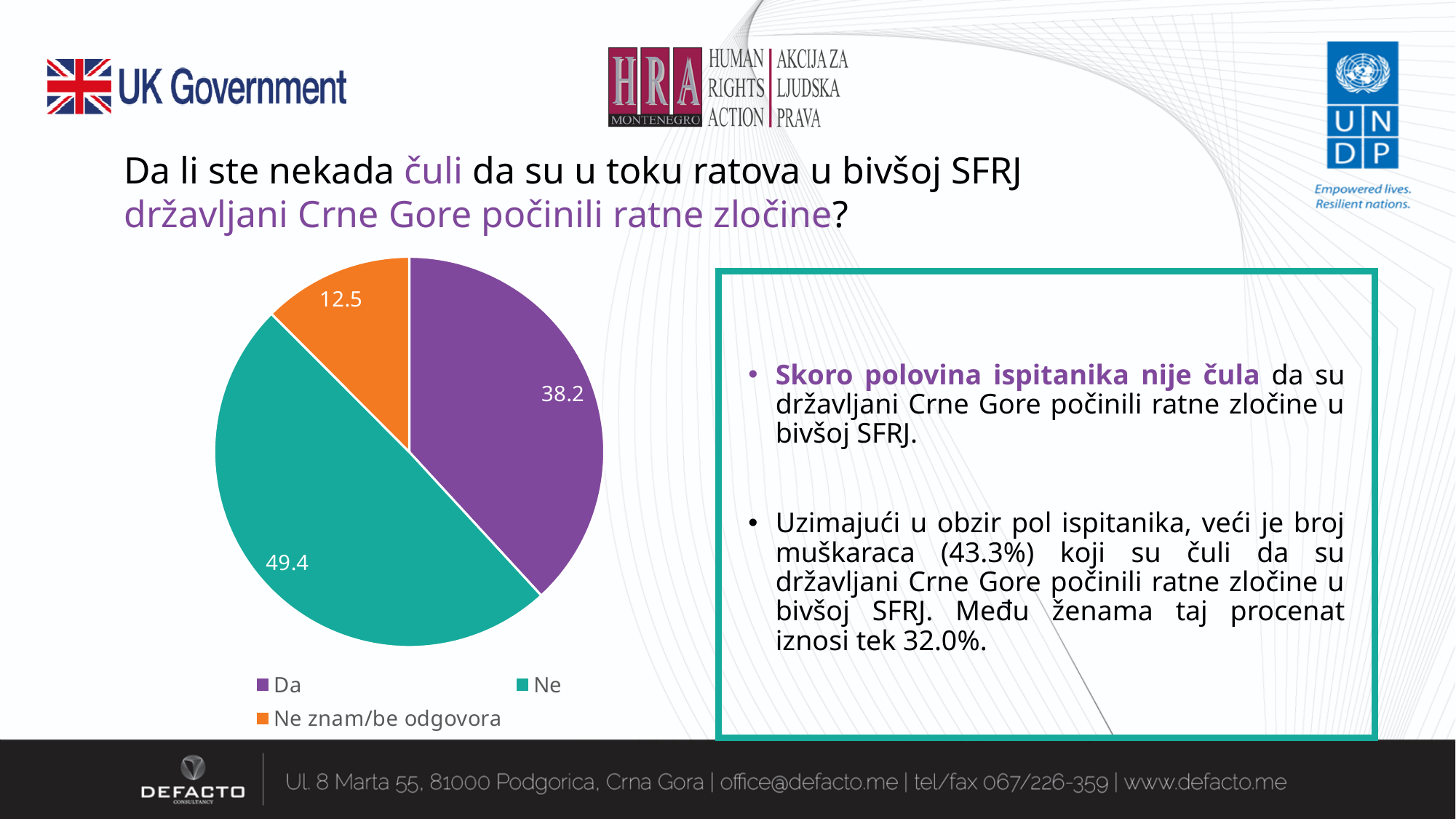
What is the value for the 'Ne znam/be odgovora' slice? 12.5 What colour is the 'Ne' slice? teal What is the difference between the 'Ne' and 'Da' values? 11.2 Which category has the largest slice? Ne How many entries does the legend list? 3 Which category has the smallest slice? Ne znam/be odgovora What type of chart is shown on the slide? pie chart What is the value for the 'Da' slice? 38.2 What is the difference between the 'Da' and 'Ne znam/be odgovora' values? 25.7 How many slices does the pie chart have? 3 Which is larger, the 'Da' slice or the 'Ne' slice? Ne What is the value for the 'Ne' slice? 49.4